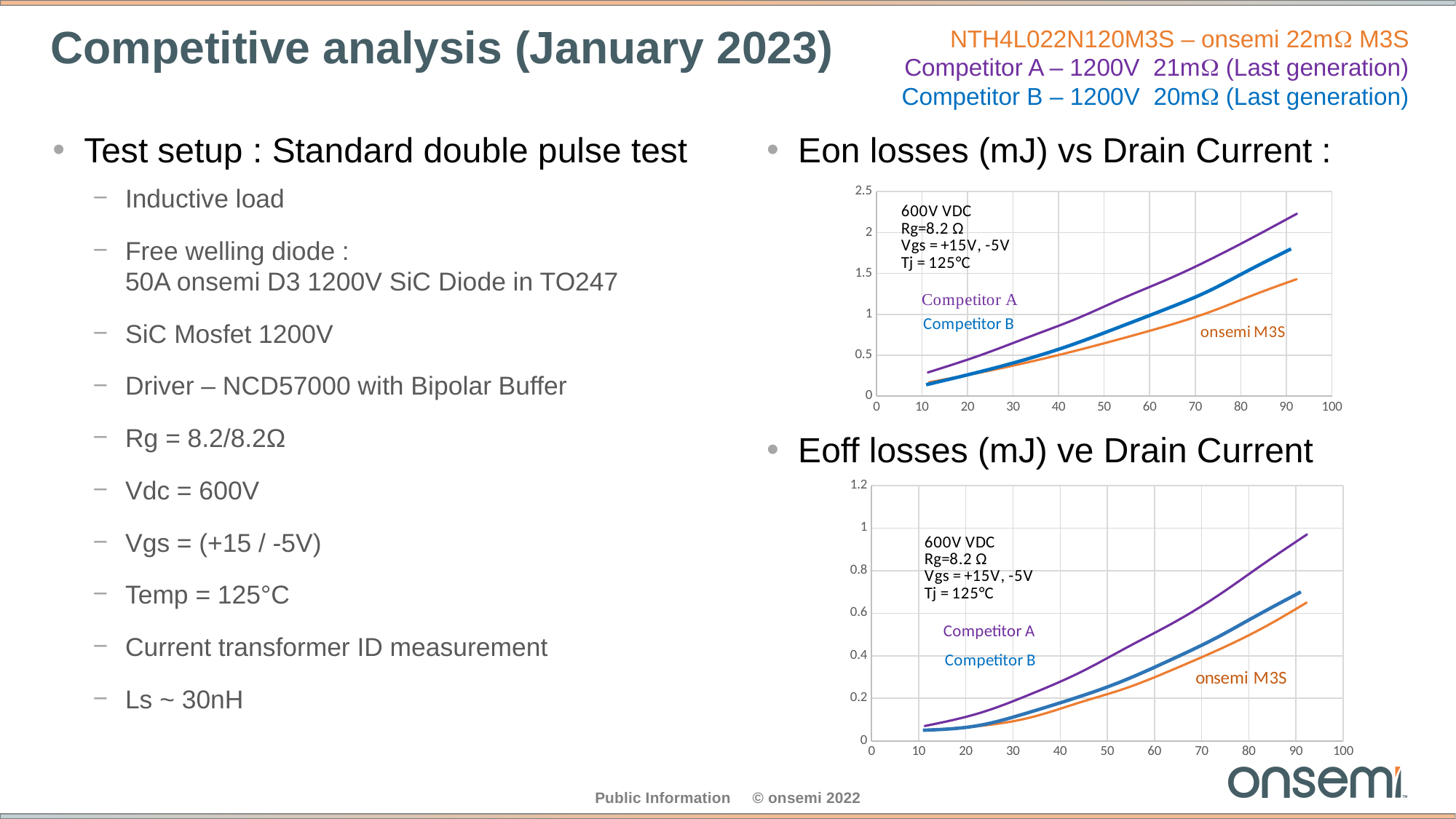
In the 'Eoff losses (mJ) ve Drain Current' chart, what is the maximum value shown on the y axis? 1.2 In the 'Eoff losses (mJ) ve Drain Current' chart, is the Eoff loss for Competitor A at 90 A greater or less than 0.8? greater In the 'Eoff losses (mJ) ve Drain Current' chart, which is larger at 70 A: the Eoff loss for Competitor A or for onsemi M3S? Competitor A How many series are plotted in the 'Eoff losses (mJ) ve Drain Current' chart? 3 What junction temperature (Tj) is stated in the annotation on the 'Eon losses (mJ) vs Drain Current' chart? 125°C In the 'Eoff losses (mJ) ve Drain Current' chart, which series has the highest Eoff losses at 90 A? Competitor A In the 'Eon losses (mJ) vs Drain Current' chart, is the Eon loss for Competitor A at 90 A greater or less than 2? greater In the 'Eon losses (mJ) vs Drain Current' chart, do the Eon losses rise or fall as drain current increases? rise In the 'Eon losses (mJ) vs Drain Current' chart, which series has the highest Eon losses at 90 A? Competitor A What kind of chart is the 'Eon losses (mJ) vs Drain Current' chart? line chart In the 'Eon losses (mJ) vs Drain Current' chart, which series has the lowest Eon losses at 90 A? onsemi M3S In the 'Eon losses (mJ) vs Drain Current' chart, is the Eon loss for onsemi M3S at 90 A greater or less than 1.5? less